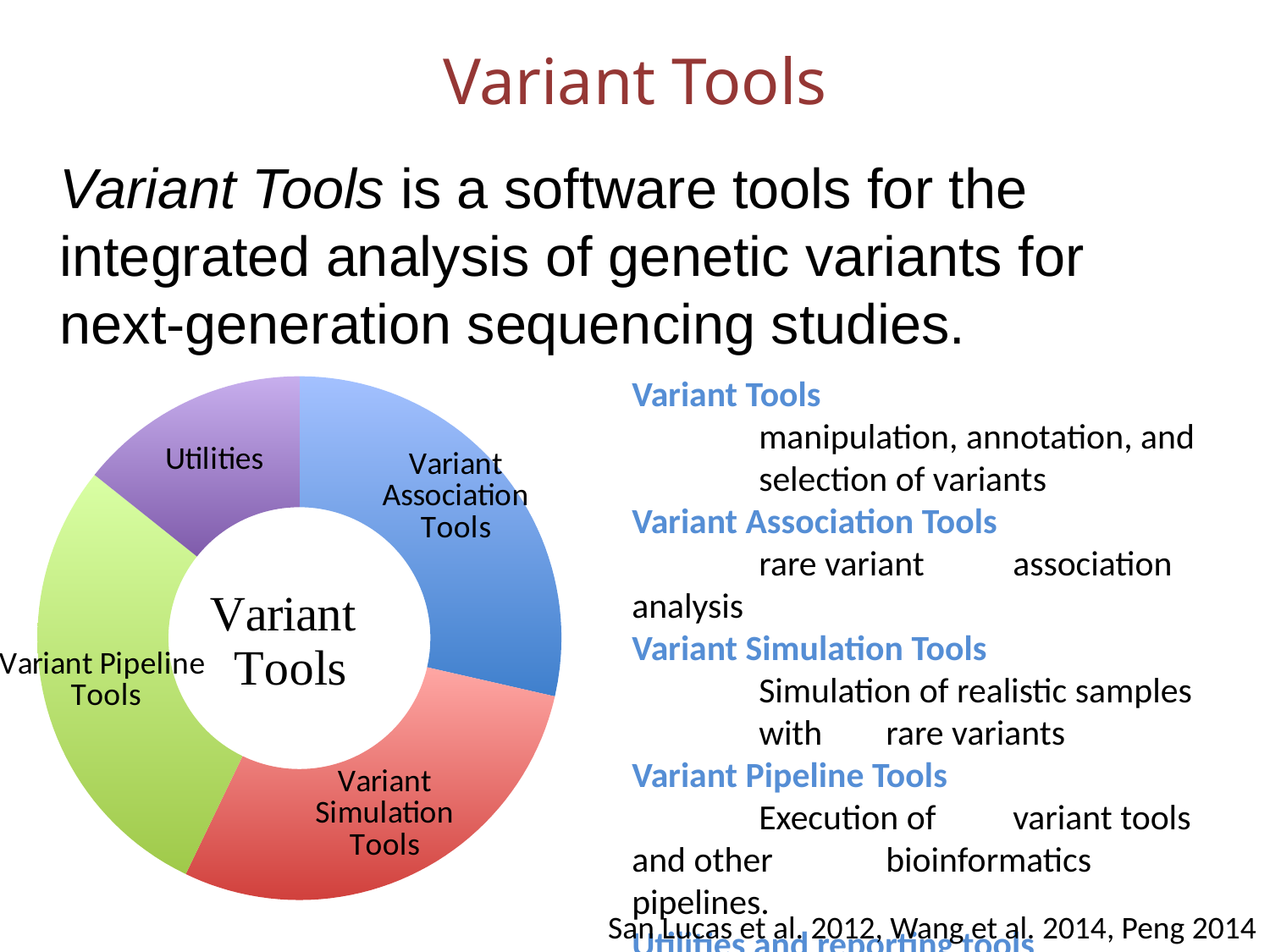
What text is written in the centre of the doughnut chart? Variant Tools How many segments does the doughnut chart have? 4 What kind of chart is shown on the slide? Doughnut (pie) chart Which segment of the doughnut chart is the smallest? Utilities Which segment is larger, Utilities or Variant Simulation Tools? Variant Simulation Tools Which segment is larger, Utilities or Variant Association Tools? Variant Association Tools What colour is the Variant Simulation Tools segment of the doughnut chart? Red